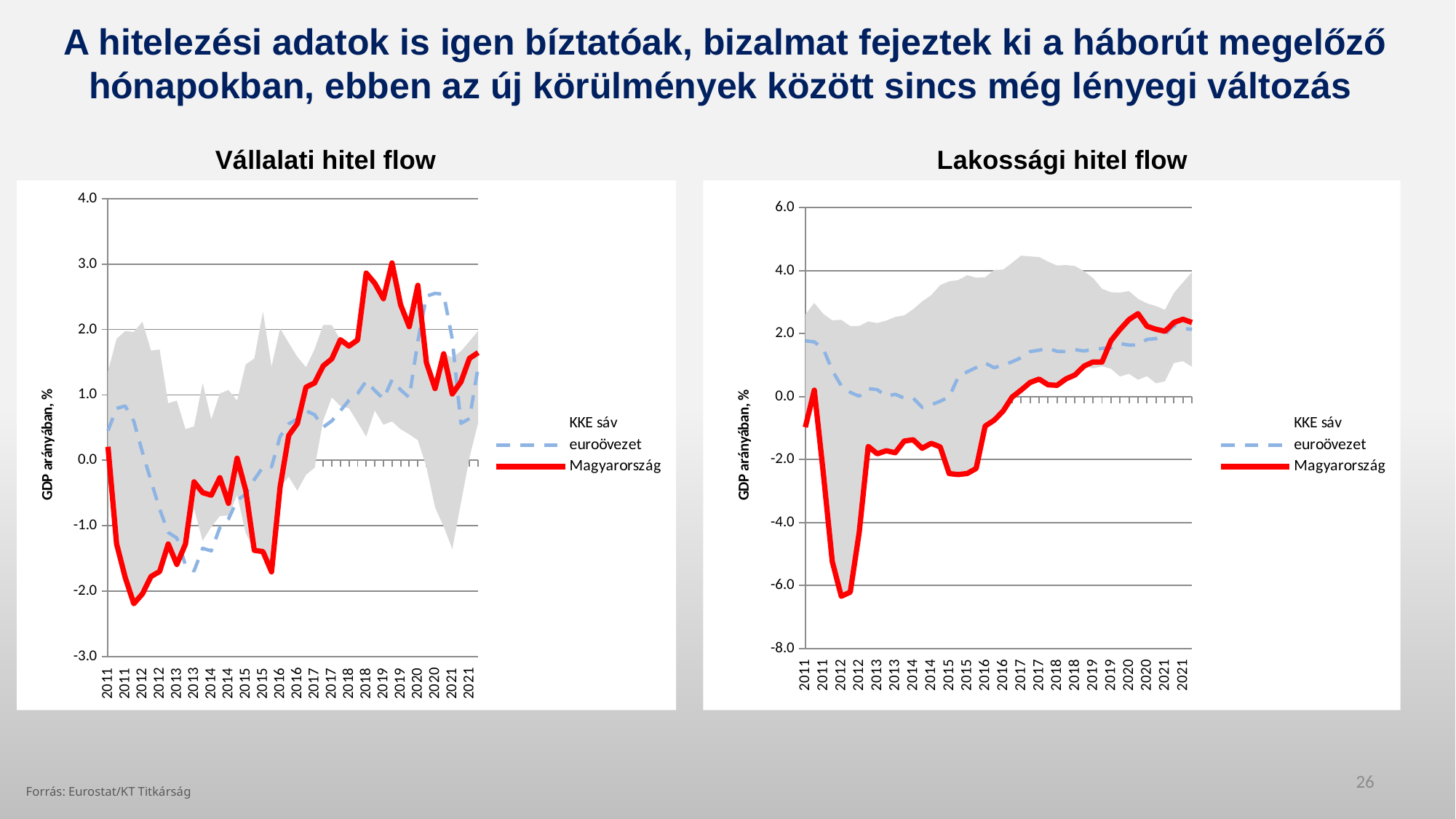
In the 'Vállalati hitel flow' chart, which series reaches the higher peak, Magyarország or euroövezet? Magyarország What kind of chart is the 'Vállalati hitel flow' chart? combination area and line chart In the 'Lakossági hitel flow' chart, which series reaches the lower minimum, Magyarország or euroövezet? Magyarország How many series does the legend of the 'Lakossági hitel flow' chart list? 3 In the 'Vállalati hitel flow' chart, is the highest value of the Magyarország line greater or less than 2.0? greater In the 'Lakossági hitel flow' chart, does the Magyarország line overall rise or fall from 2012 to 2021? rise What is the y-axis label of the 'Lakossági hitel flow' chart? GDP arányában, % In the 'Vállalati hitel flow' chart, does the Magyarország line rise or fall between 2011 and 2012? fall In the 'Vállalati hitel flow' chart, which series is drawn as a solid red line? Magyarország In the 'Vállalati hitel flow' chart, is the lowest value of the Magyarország line greater or less than -1.0? less In the 'Lakossági hitel flow' chart, is the last 2021 value of the Magyarország line greater or less than 2.0? greater